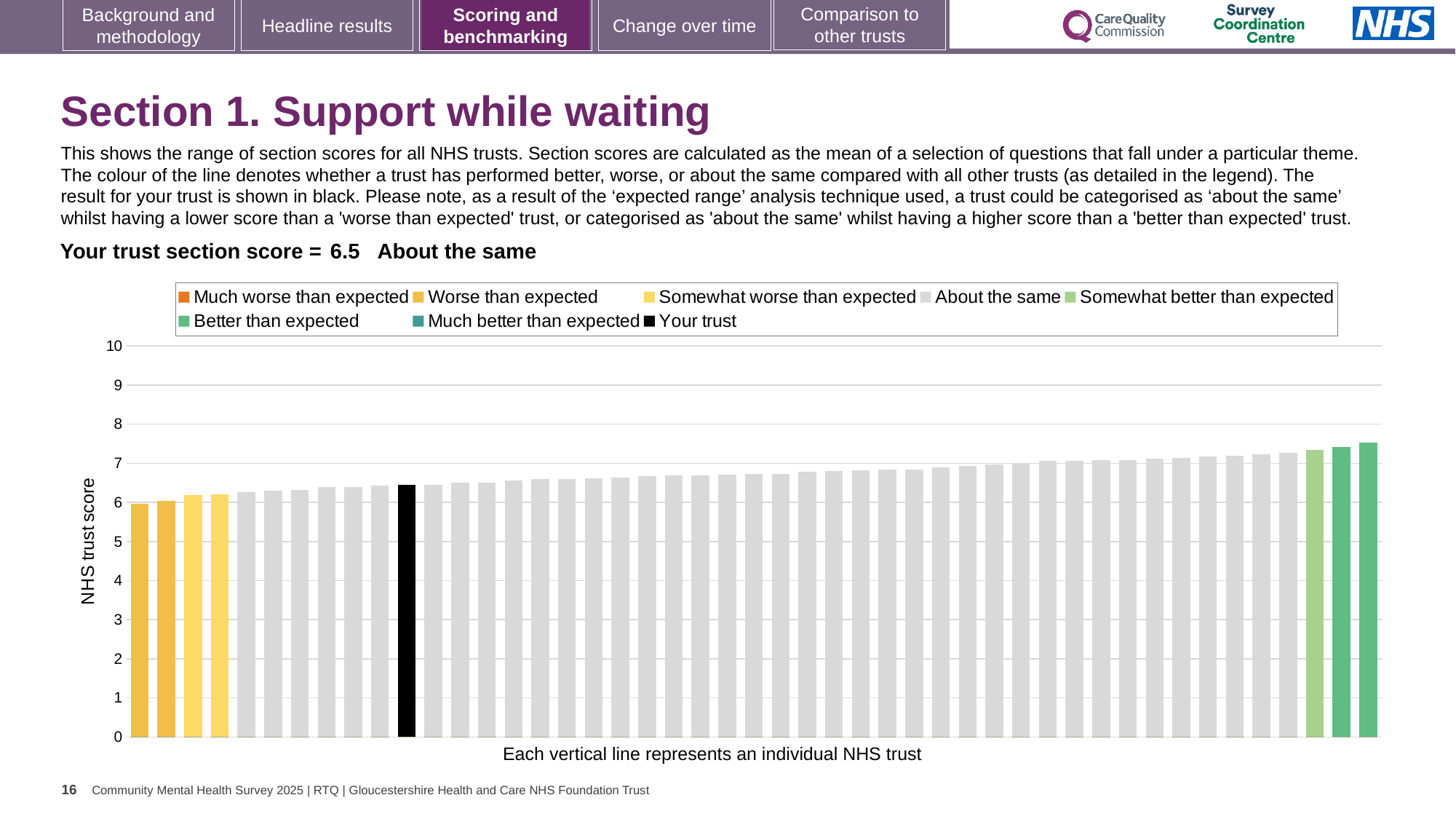
Which is larger, the rightmost bar or the leftmost bar? the rightmost bar How many entries does the chart legend list? 8 How many bars are coloured as 'Better than expected'? 2 Which legend category does the tallest bar belong to? Better than expected Is the value of the tallest bar greater or less than 7? greater Is the value of the leftmost bar greater or less than 5? greater Is the value of the black 'Your trust' bar greater or less than 6? greater Do the bar values rise or fall from left to right along the x axis? rise How many bars are coloured as 'Somewhat better than expected'? 1 What kind of chart is shown on the slide? bar chart What is the section score for your trust shown on the slide? 6.5 What is the title of the vertical axis? NHS trust score